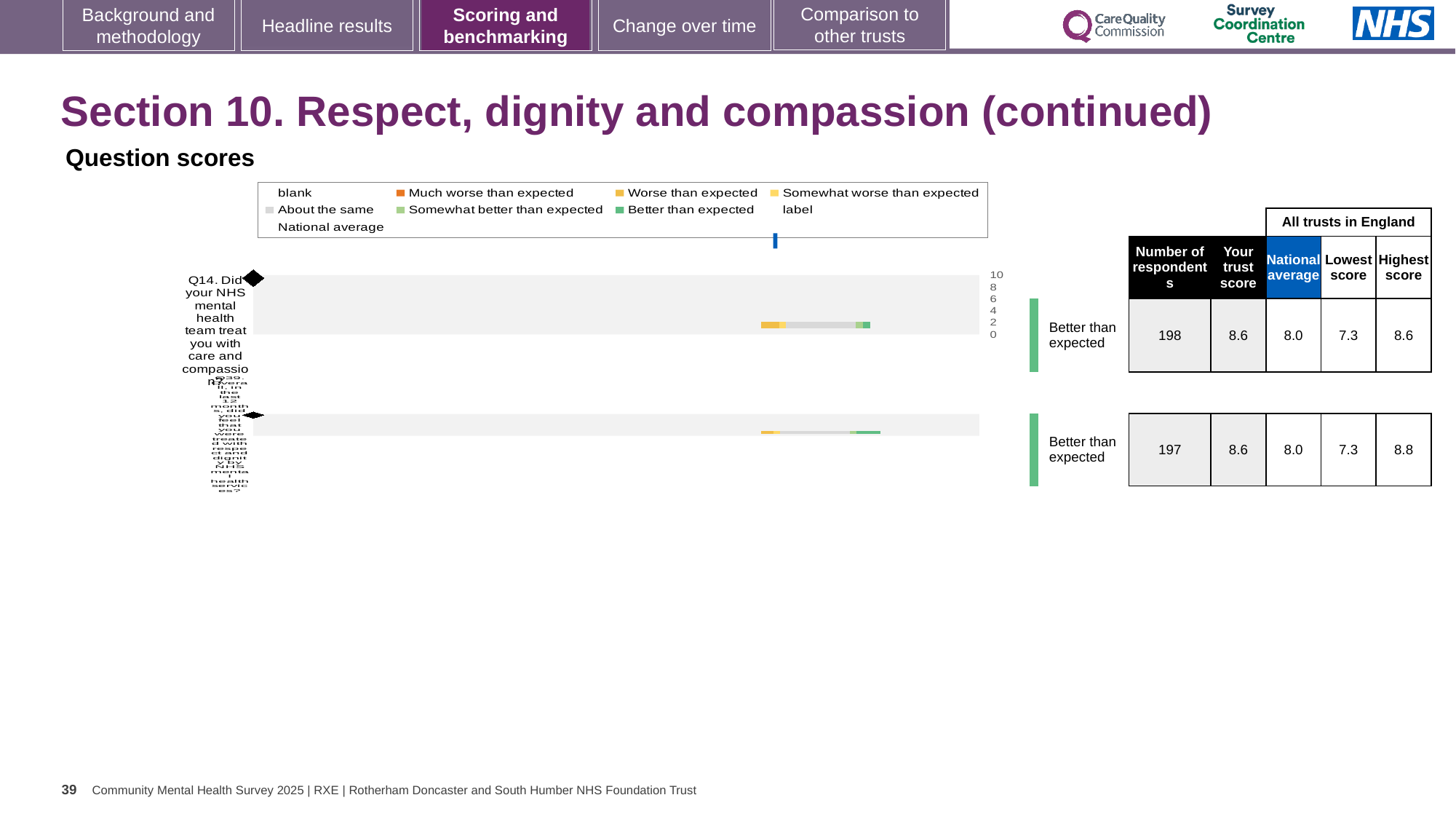
What colour does the legend use for 'Better than expected'? green What is the number of respondents for Q14 (Did your NHS mental health team treat you with care and compassion?)? 198 What is the trust score for Q14? 8.6 What is the highest score among all trusts in England for Q39, the second question on the slide? 8.8 How many survey questions are plotted in the question scores chart? 2 What kind of chart is used to show the question scores on this slide? bar chart What benchmark category is shown next to the Q14 bar? Better than expected For Q14, which is larger: the trust score or the national average? the trust score What is the lowest score among all trusts in England for Q14? 7.3 By how much does the trust score for Q14 exceed the national average for Q14? 0.6 What is the national average score for Q14? 8.0 What is the number of respondents for Q39, the second question on the slide? 197